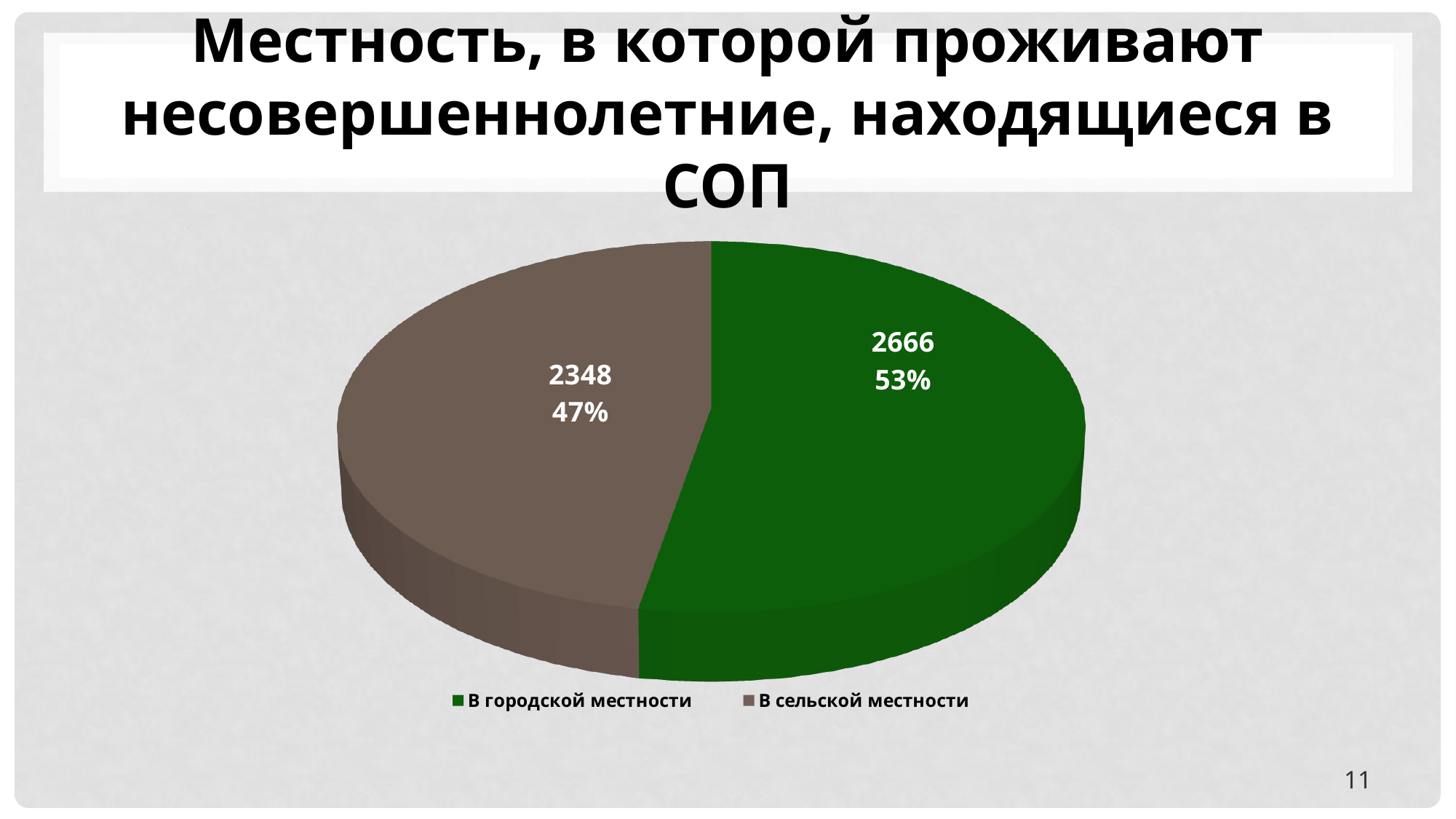
Which category has the smallest slice? В сельской местности Which is larger: the value for 'В городской местности' or 'В сельской местности'? В городской местности How many slices does the pie chart have? 2 What colour is the slice for 'В сельской местности'? brown What type of chart is shown on the slide? pie chart What share of the pie does 'В сельской местности' represent? 47% What is the value for 'В городской местности'? 2666 How many entries does the legend list? 2 Which category has the largest slice? В городской местности What is the value for 'В сельской местности'? 2348 What share of the pie does 'В городской местности' represent? 53% What is the difference between the values for 'В городской местности' and 'В сельской местности'? 318